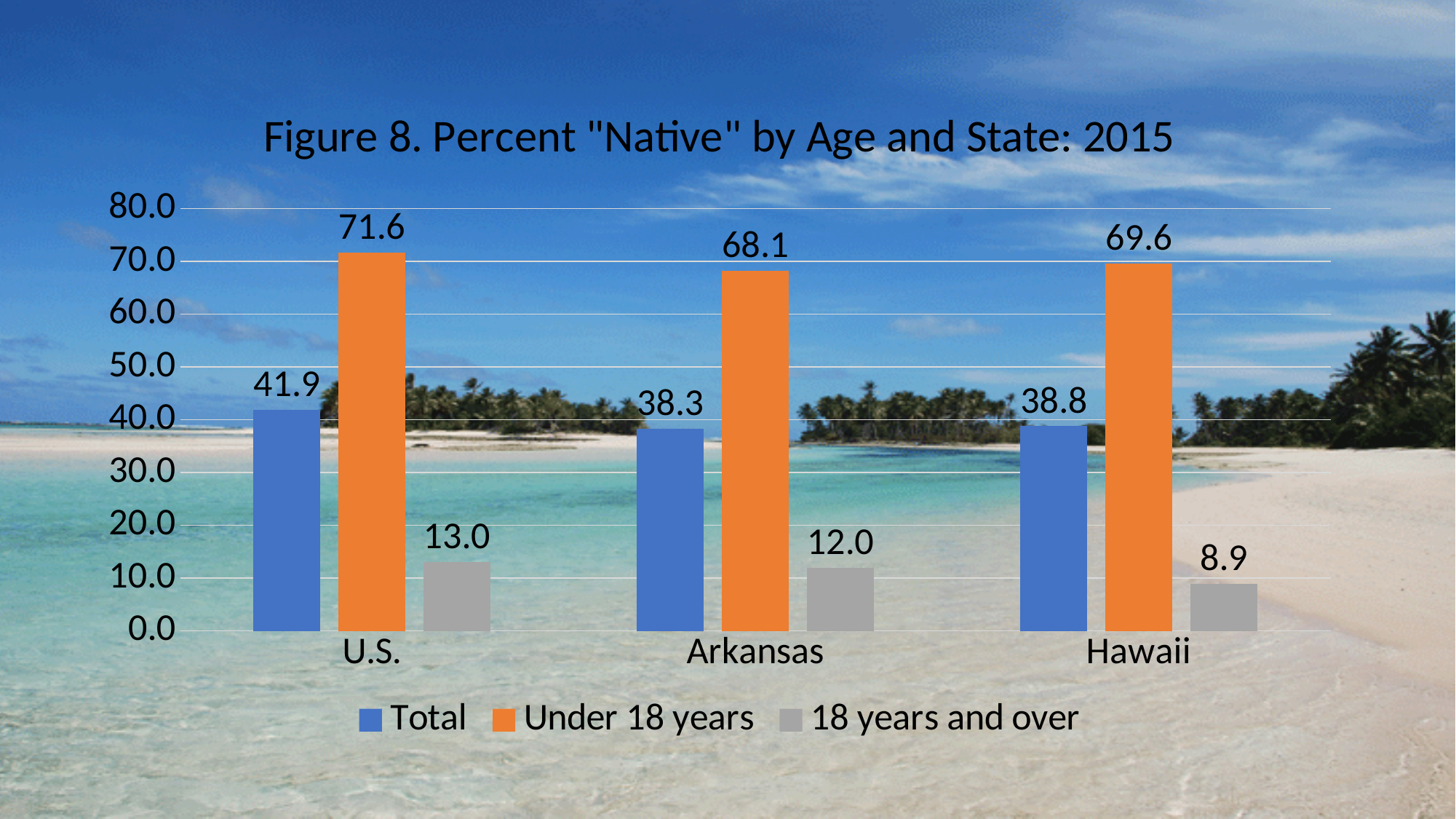
What is the title of the chart? Figure 8. Percent "Native" by Age and State: 2015 Which category has the highest Under 18 years value? U.S. Which category has the lowest 18 years and over value? Hawaii What kind of chart is shown on the slide? bar chart What is the difference between the Under 18 years and 18 years and over values for the U.S.? 58.6 How many categories are shown on the x axis? 3 What is the Total value for the U.S.? 41.9 How many series does the legend list? 3 Which is larger, the Total value for Arkansas or the Total value for Hawaii? Hawaii What is the 18 years and over value for Hawaii? 8.9 What is the Under 18 years value for Arkansas? 68.1 Is the Under 18 years value for Hawaii greater or less than 60.0? greater